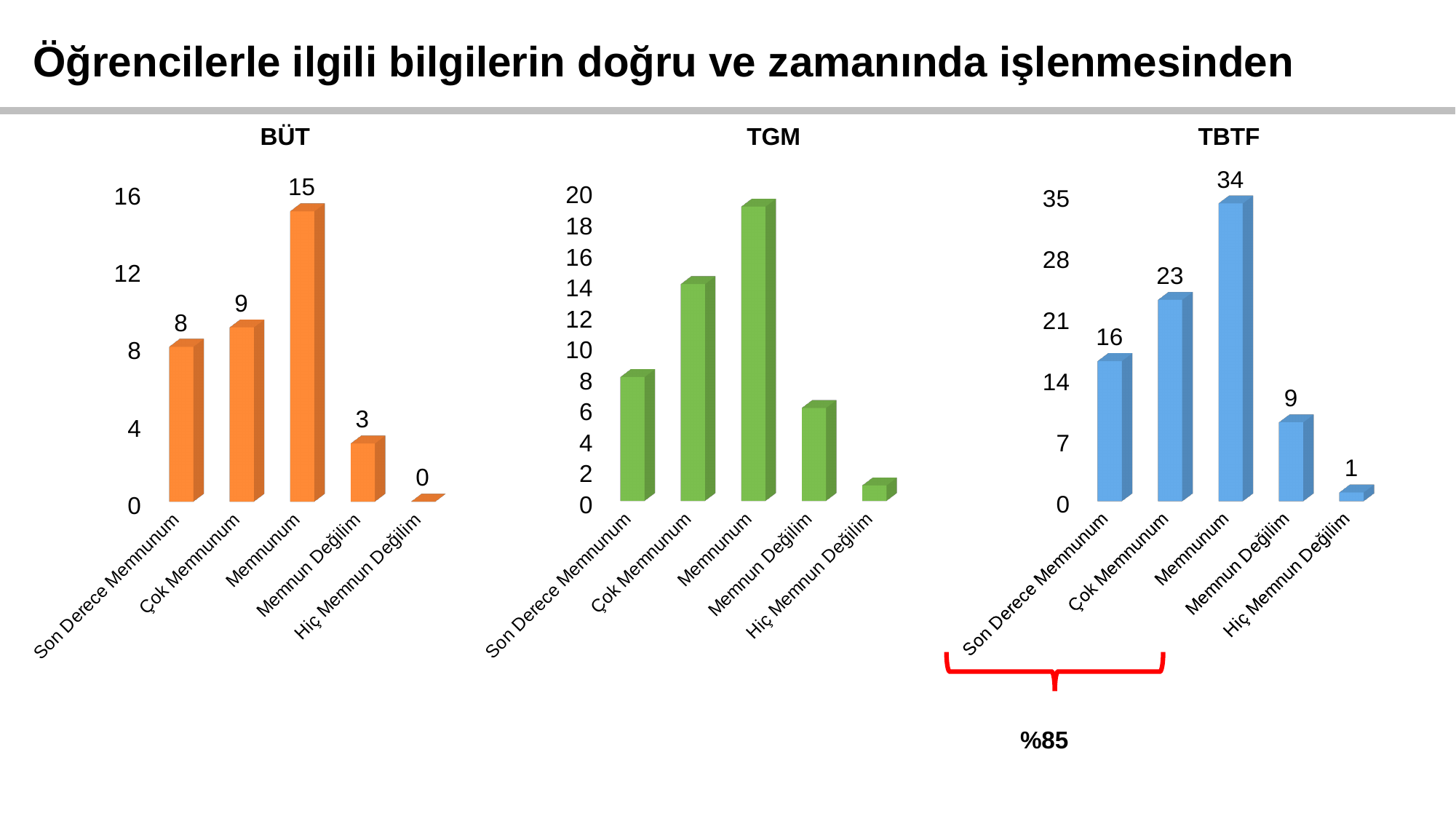
In the BÜT chart, which category has the highest value? Memnunum What kind of chart is the TGM chart? bar chart In the TGM chart, is the value for Memnun Değilim greater or less than 10? less In the TBTF chart, which is larger, Memnun Değilim or Hiç Memnun Değilim? Memnun Değilim In the BÜT chart, what is the value for Memnunum? 15 In the TGM chart, is the value for Memnunum greater or less than 16? greater In the TBTF chart, what is the value for Çok Memnunum? 23 In the TGM chart, which category has the lowest value? Hiç Memnun Değilim How many categories does the TBTF chart show? 5 In the BÜT chart, what is the value for Hiç Memnun Değilim? 0 In the TBTF chart, what is the difference between Memnunum and Son Derece Memnunum? 18 In the BÜT chart, what is the difference between Çok Memnunum and Son Derece Memnunum? 1